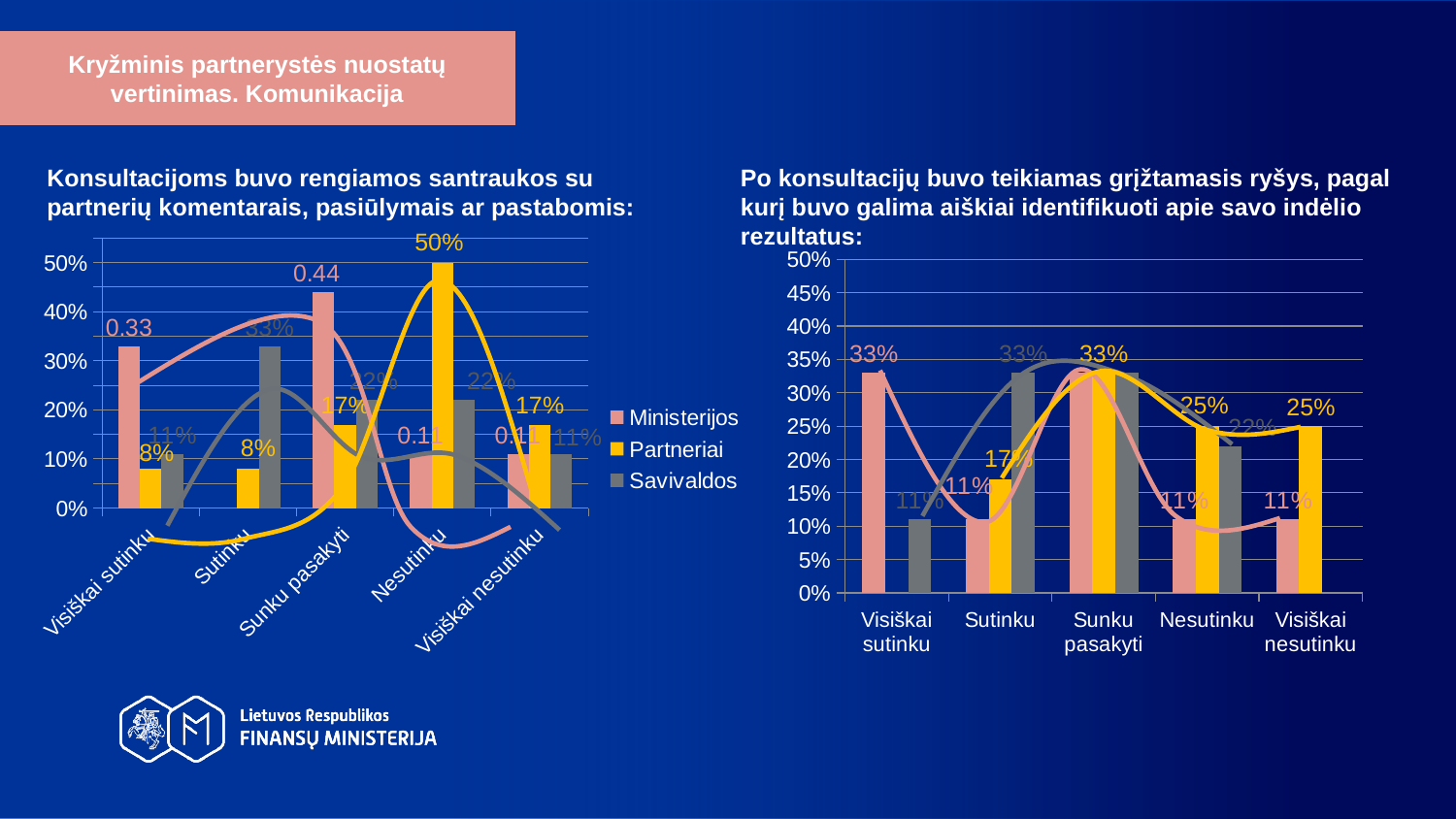
In the left chart (Konsultacijoms buvo rengiamos santraukos...), what is the Partneriai value for Nesutinku? 50% How many categories are shown on the x axis of the left chart (Konsultacijoms buvo rengiamos santraukos...)? 5 In the left chart (Konsultacijoms buvo rengiamos santraukos...), what is the Ministerijos value for Sunku pasakyti? 0.44 In the left chart (Konsultacijoms buvo rengiamos santraukos...), which category has the highest Partneriai value? Nesutinku In the right chart (Po konsultacijų buvo teikiamas grįžtamasis ryšys...), what is the Partneriai value for Visiškai nesutinku? 25% How many series does the legend list? 3 In the left chart (Konsultacijoms buvo rengiamos santraukos...), what is the Savivaldos value for Sutinku? 33% In the right chart (Po konsultacijų buvo teikiamas grįžtamasis ryšys...), which is larger for Nesutinku: the Partneriai value or the Ministerijos value? Partneriai In the right chart (Po konsultacijų buvo teikiamas grįžtamasis ryšys...), what is the difference between the Savivaldos and Ministerijos values for Sutinku? 22 percentage points What kind of chart is the right chart (Po konsultacijų buvo teikiamas grįžtamasis ryšys...)? Bar chart In the right chart (Po konsultacijų buvo teikiamas grįžtamasis ryšys...), what is the Ministerijos value for Visiškai sutinku? 33% In the right chart (Po konsultacijų buvo teikiamas grįžtamasis ryšys...), what is the Savivaldos value for Sutinku? 33%